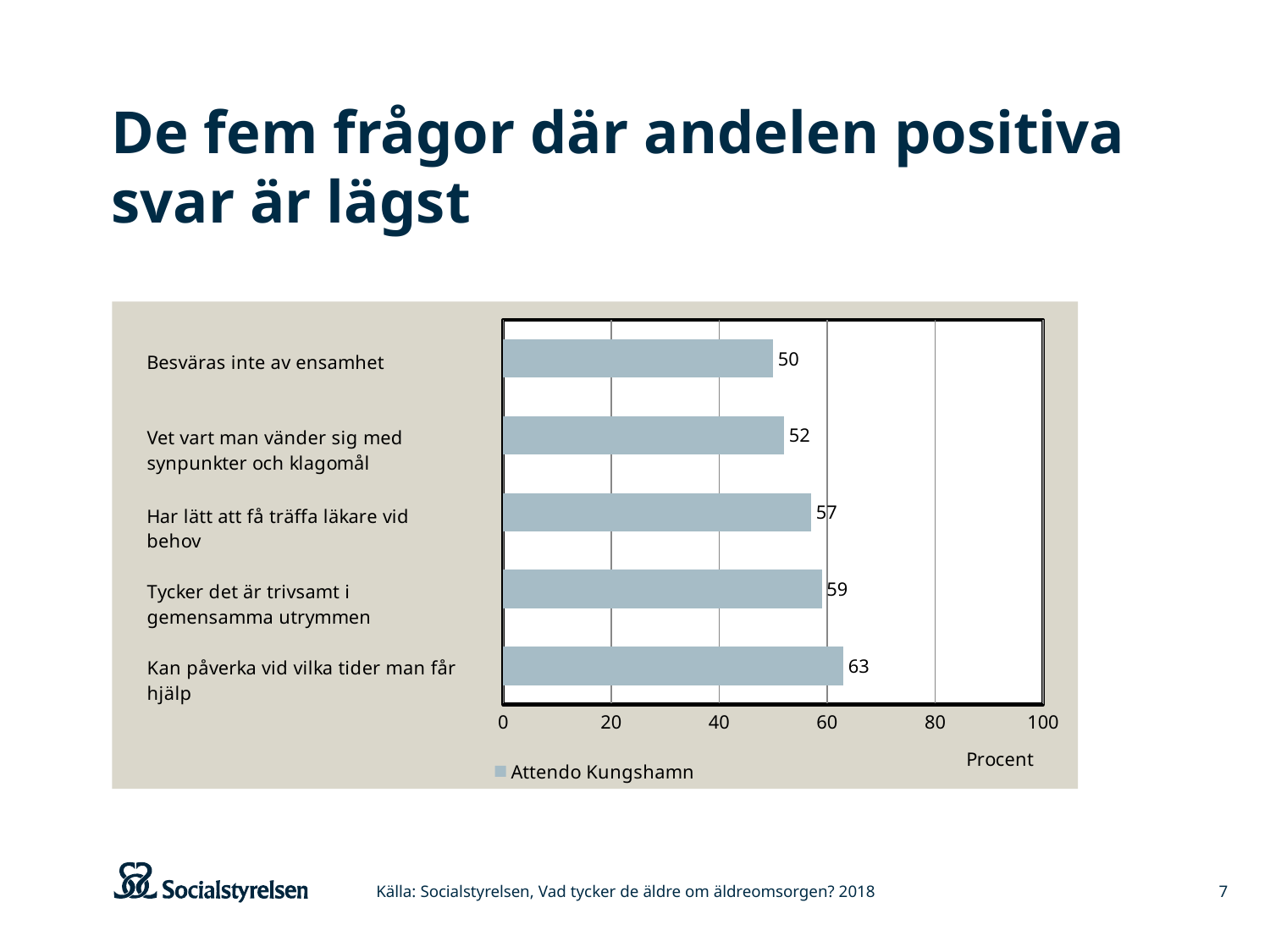
How many categories are shown in the chart? 5 What is the difference between the values for "Kan påverka vid vilka tider man får hjälp" and "Besväras inte av ensamhet"? 13 Which is larger: the value for "Tycker det är trivsamt i gemensamma utrymmen" or the value for "Vet vart man vänder sig med synpunkter och klagomål"? Tycker det är trivsamt i gemensamma utrymmen Which category has the highest value? Kan påverka vid vilka tider man får hjälp What is the value for "Kan påverka vid vilka tider man får hjälp"? 63 What series name is shown in the legend? Attendo Kungshamn Is the value for "Tycker det är trivsamt i gemensamma utrymmen" greater or less than 40? greater What is the value for "Besväras inte av ensamhet"? 50 What is the value for "Har lätt att få träffa läkare vid behov"? 57 What kind of chart is shown on the slide? bar chart Which category has the lowest value? Besväras inte av ensamhet How many series does the legend list? 1